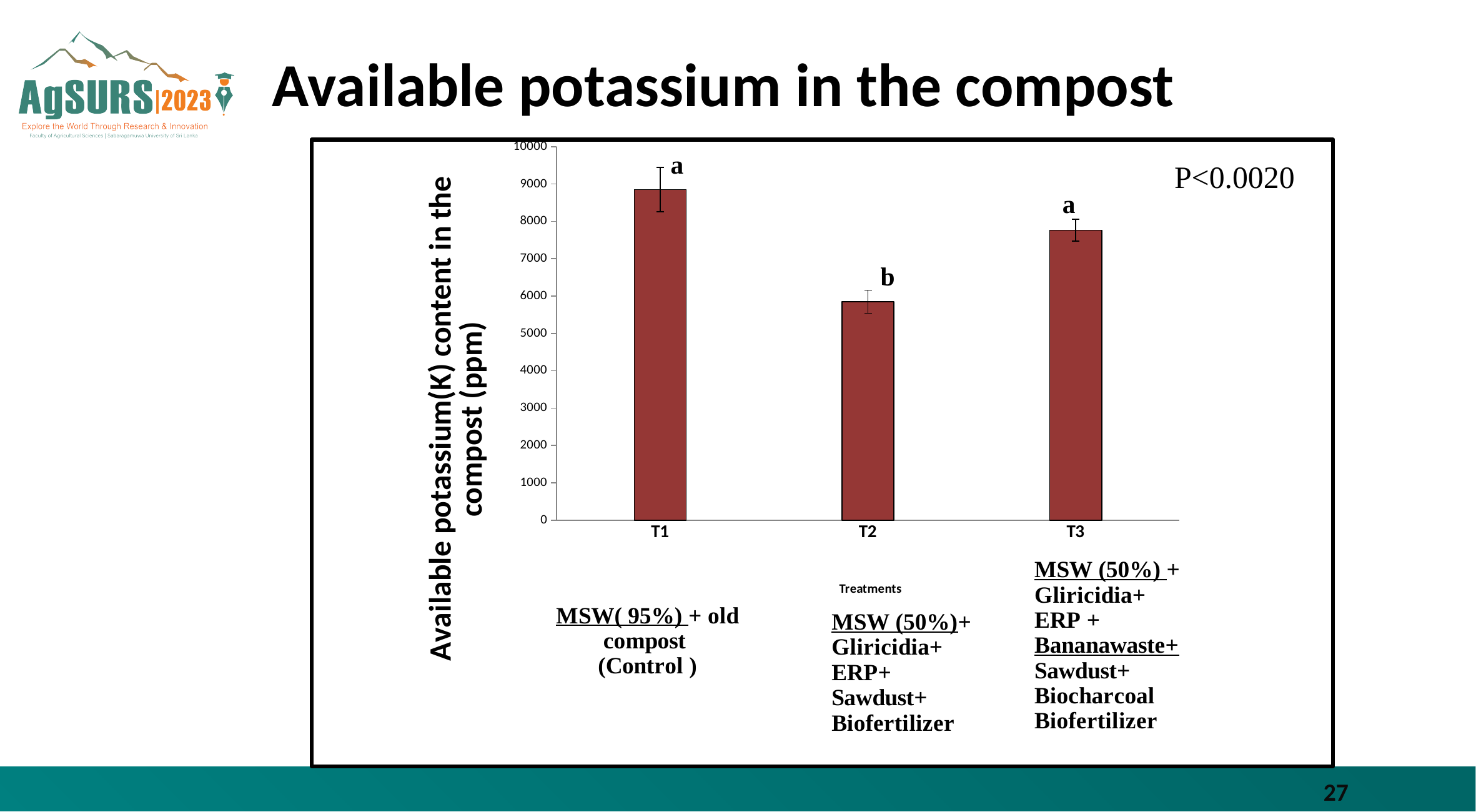
What is the highest value shown on the y axis? 10000 Which significance letter is shown above the T2 bar? b Is the value for T2 greater or less than 5000? greater Which treatment has the lowest available potassium content? T2 What is the label of the y axis? Available potassium(K) content in the compost (ppm) Which has a higher available potassium content, T2 or T3? T3 Is the value for T3 greater or less than 7000? greater What kind of chart is shown on the slide? bar chart Is the value for T1 greater or less than 8000? greater How many treatments (bars) are plotted in the chart? 3 Which treatment has the highest available potassium content? T1